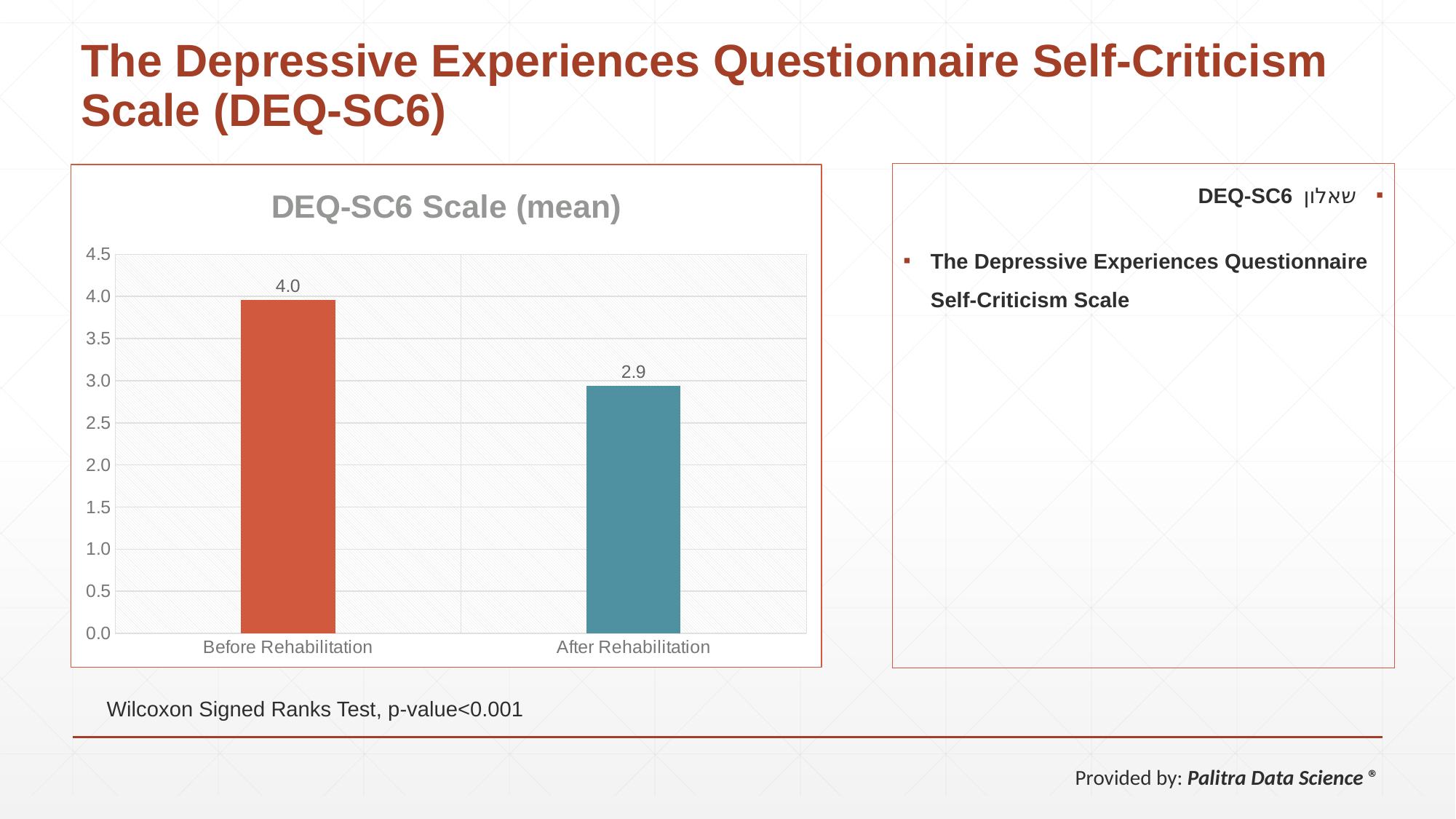
Which is larger, the mean for Before Rehabilitation or for After Rehabilitation? Before Rehabilitation What is the mean DEQ-SC6 value for Before Rehabilitation? 4.0 What is the difference between the Before Rehabilitation and After Rehabilitation mean values? 1.1 What is the title of the chart? DEQ-SC6 Scale (mean) Which category has the highest mean DEQ-SC6 value? Before Rehabilitation What kind of chart is shown on the slide? bar chart Do the values rise or fall from Before Rehabilitation to After Rehabilitation? fall Which category has the lowest mean DEQ-SC6 value? After Rehabilitation What is the mean DEQ-SC6 value for After Rehabilitation? 2.9 How many categories are shown on the chart? 2 Is the value for After Rehabilitation greater or less than 3.0? less Is the value for Before Rehabilitation greater or less than 3.5? greater